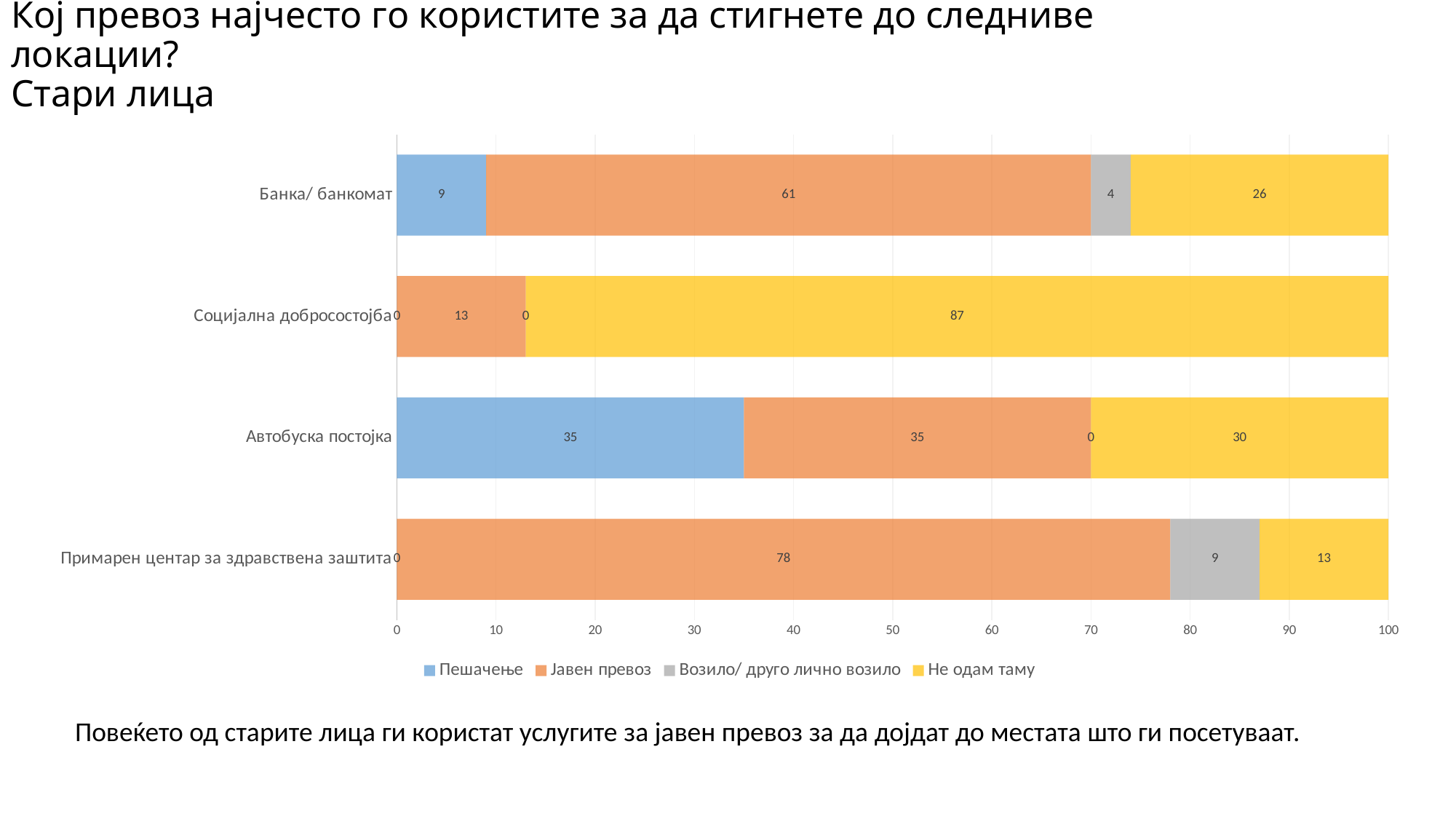
How many series does the legend list? 4 What is the value of Јавен превоз for Банка/ банкомат? 61 How many location categories are plotted on the chart? 4 What is the value of Возило/ друго лично возило for Примарен центар за здравствена заштита? 9 What is the difference between the Јавен превоз values for Примарен центар за здравствена заштита and Банка/ банкомат? 17 What is the total of the stacked bar for Банка/ банкомат? 100 Which location has the lowest value for Не одам таму? Примарен центар за здравствена заштита What type of chart is shown on the slide? stacked bar chart What is the value of Пешачење for Автобуска постојка? 35 Which location has the highest value for Јавен превоз? Примарен центар за здравствена заштита What is the value of Не одам таму for Социјална добросостојба? 87 Which is larger: Не одам таму for Банка/ банкомат or Не одам таму for Автобуска постојка? Автобуска постојка